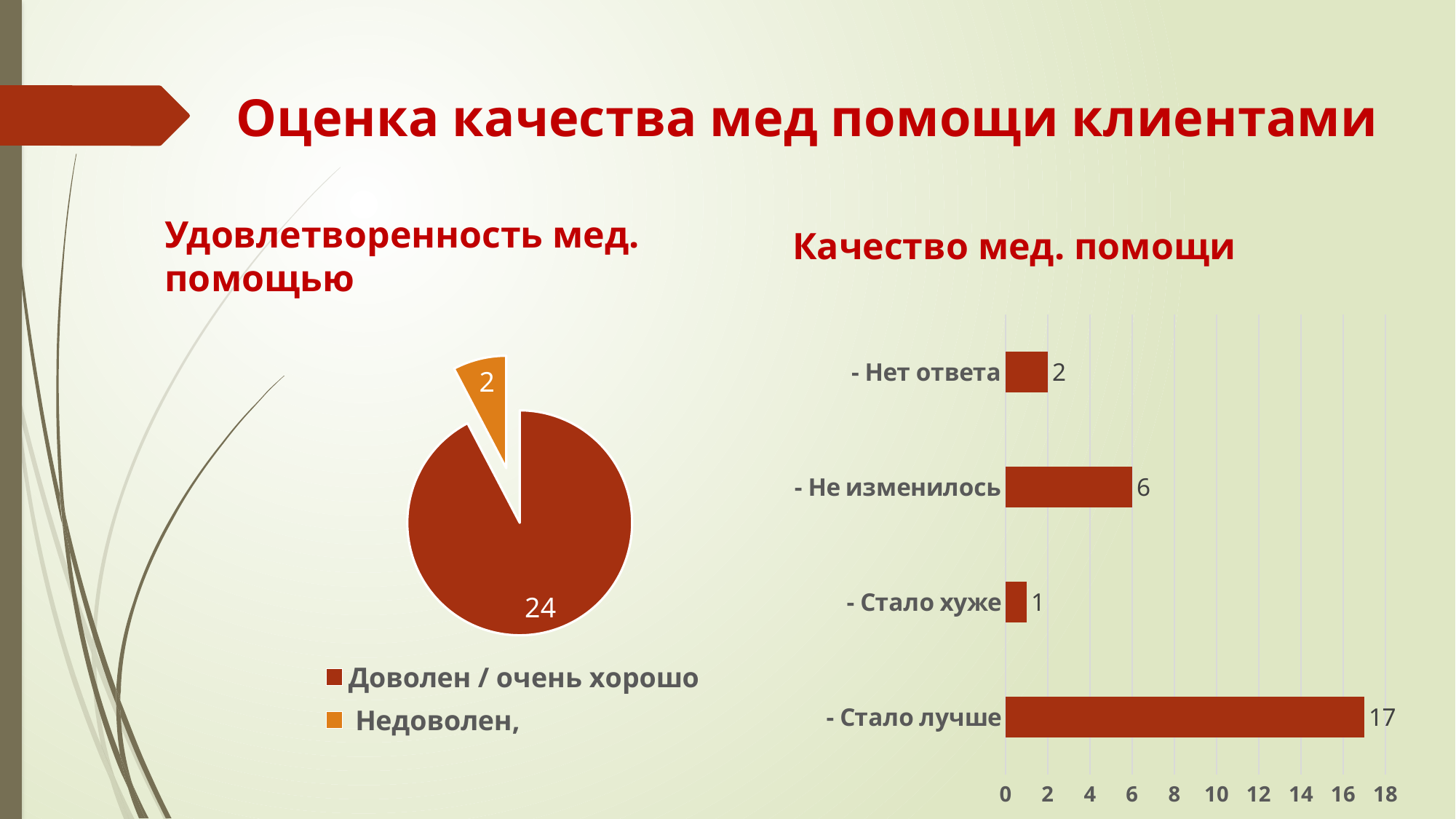
In the bar chart 'Качество мед. помощи', how many categories are shown? 4 In the bar chart 'Качество мед. помощи', what is the value for 'Стало лучше'? 17 In the pie chart 'Удовлетворенность мед. помощью', which colour is the 'Недоволен' slice? Orange In the pie chart 'Удовлетворенность мед. помощью', what is the difference between 'Доволен / очень хорошо' and 'Недоволен'? 22 In the pie chart 'Удовлетворенность мед. помощью', how many slices are there? 2 In the bar chart 'Качество мед. помощи', which category has the lowest value? Стало хуже In the bar chart 'Качество мед. помощи', which category has the highest value? Стало лучше What kind of chart is 'Качество мед. помощи'? Bar chart In the bar chart 'Качество мед. помощи', what is the difference between 'Стало лучше' and 'Не изменилось'? 11 In the bar chart 'Качество мед. помощи', what is the value for 'Не изменилось'? 6 In the pie chart 'Удовлетворенность мед. помощью', what is the value for 'Недоволен'? 2 In the pie chart 'Удовлетворенность мед. помощью', what is the value for 'Доволен / очень хорошо'? 24